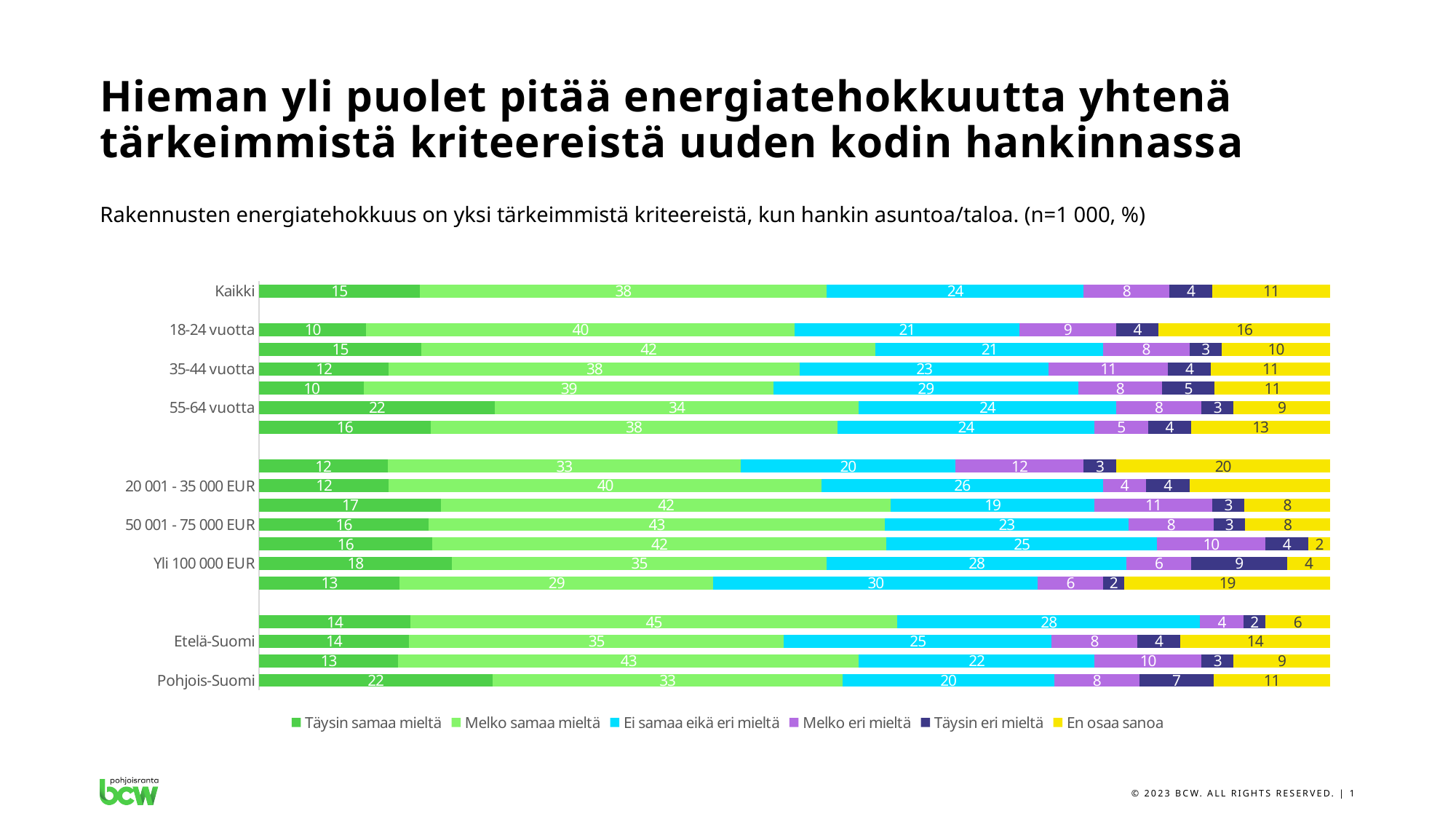
What kind of chart is shown on the slide? Stacked bar chart What is the value of "Ei samaa eikä eri mieltä" for Etelä-Suomi? 25 What is the value of "En osaa sanoa" for Yli 100 000 EUR? 4 What is the difference between the "Täysin samaa mieltä" values for 55-64 vuotta and 35-44 vuotta? 10 What is the value of "Täysin eri mieltä" for Pohjois-Suomi? 7 Which series is shown in yellow in the legend? En osaa sanoa Which is larger, the "Melko samaa mieltä" value for 50 001 - 75 000 EUR or for Pohjois-Suomi? 50 001 - 75 000 EUR What is the value of "Täysin samaa mieltä" for Kaikki? 15 What is the value of "Melko samaa mieltä" for 18-24 vuotta? 40 What is the total of the stacked bar for Kaikki? 100 How many series does the legend list? 6 What is the value of "Melko eri mieltä" for 20 001 - 35 000 EUR? 4